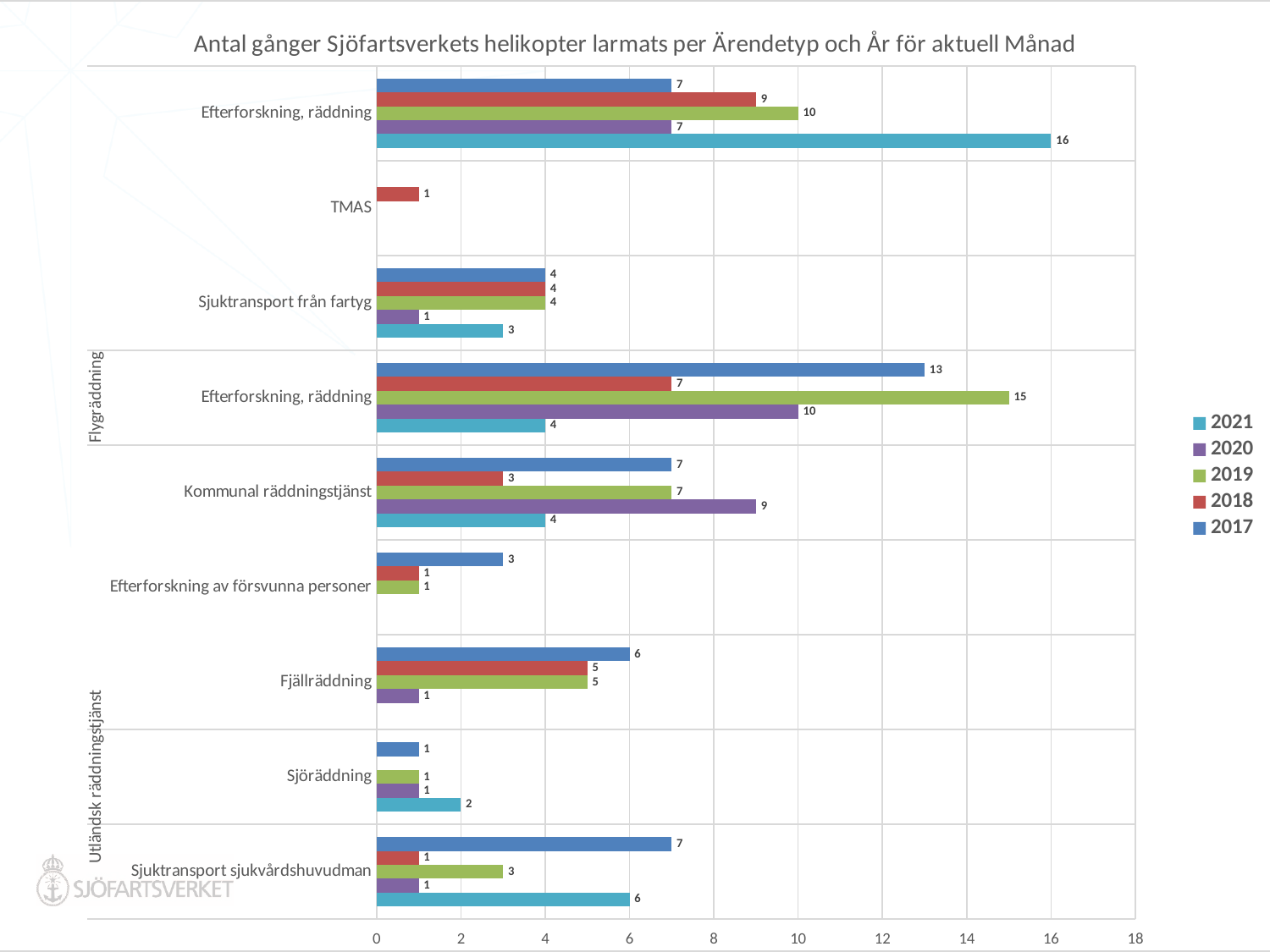
What is the value for Sjuktransport från fartyg in 2020? 1 How many categories (ärendetyper) are shown on the vertical axis? 9 What is the value for TMAS in 2018? 1 What kind of chart is shown on the slide? Bar chart How many years does the legend list? 5 What is the highest value shown anywhere in the chart? 16 For the 'Efterforskning, räddning' category under Flygräddning, which year has the lowest value? 2021 For the topmost 'Efterforskning, räddning' category, which year has the highest value? 2021 For Fjällräddning, which is larger: the 2017 value or the 2020 value? 2017 What is the value for Kommunal räddningstjänst in 2020? 9 What is the value for Sjuktransport sjukvårdshuvudman in 2021? 6 For the 'Efterforskning, räddning' category under Flygräddning, what is the difference between the 2019 value and the 2021 value? 11